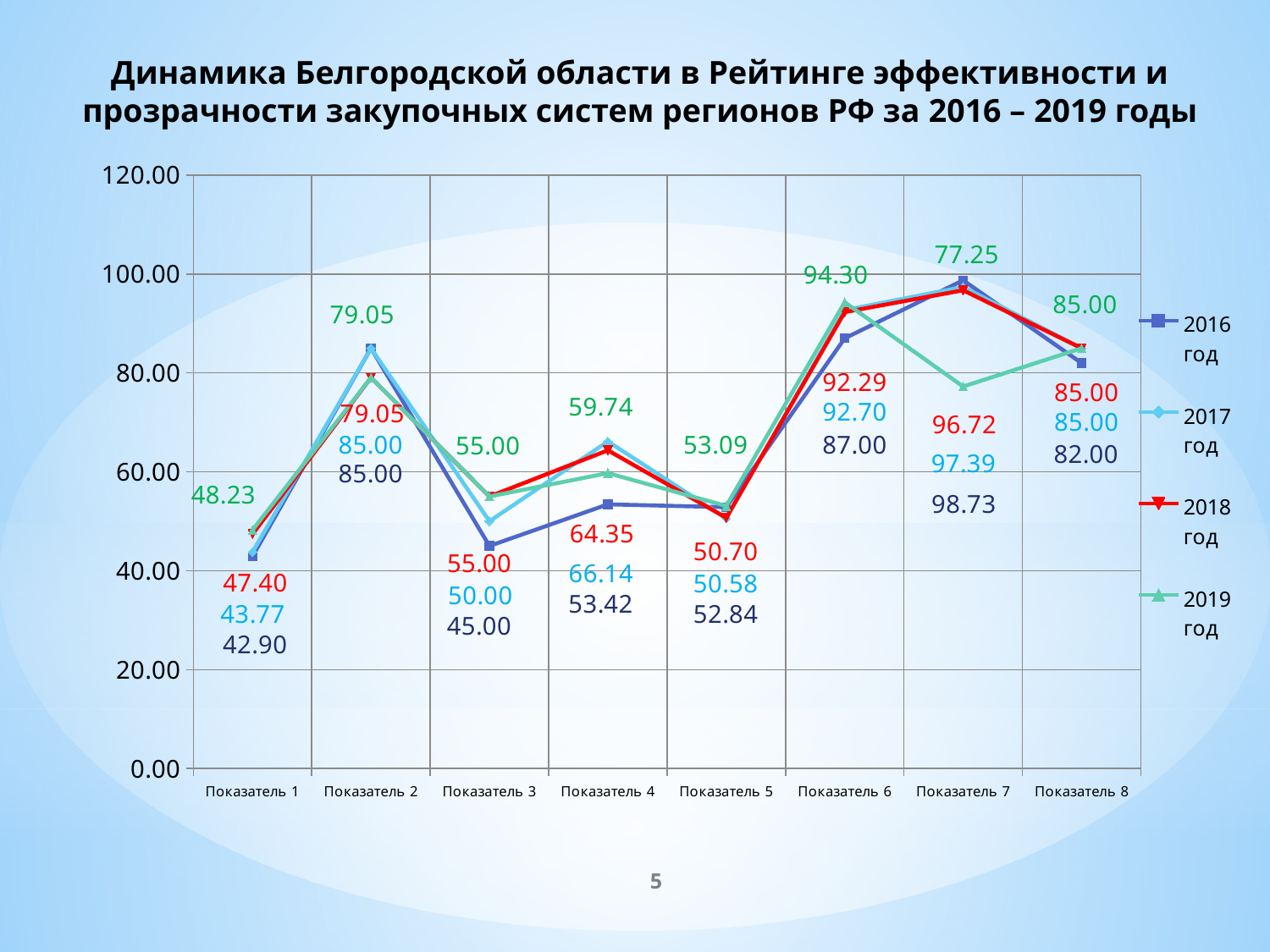
How many series does the legend list? 4 For the 2016 год series, which category has the highest value? Показатель 7 What is the value for 2016 год at Показатель 7? 98.73 What type of chart is shown on the slide? line chart How many categories (показатели) are plotted along the x axis? 8 What is the value for 2017 год at Показатель 4? 66.14 For the 2019 год series, which category has the lowest value? Показатель 1 Which series is drawn in red on the chart? 2018 год At Показатель 3, which is larger: the value for 2016 год or the value for 2019 год? 2019 год What is the value for 2018 год at Показатель 5? 50.70 What is the value for 2019 год at Показатель 1? 48.23 What is the difference between the 2016 год and 2019 год values at Показатель 7? 21.48